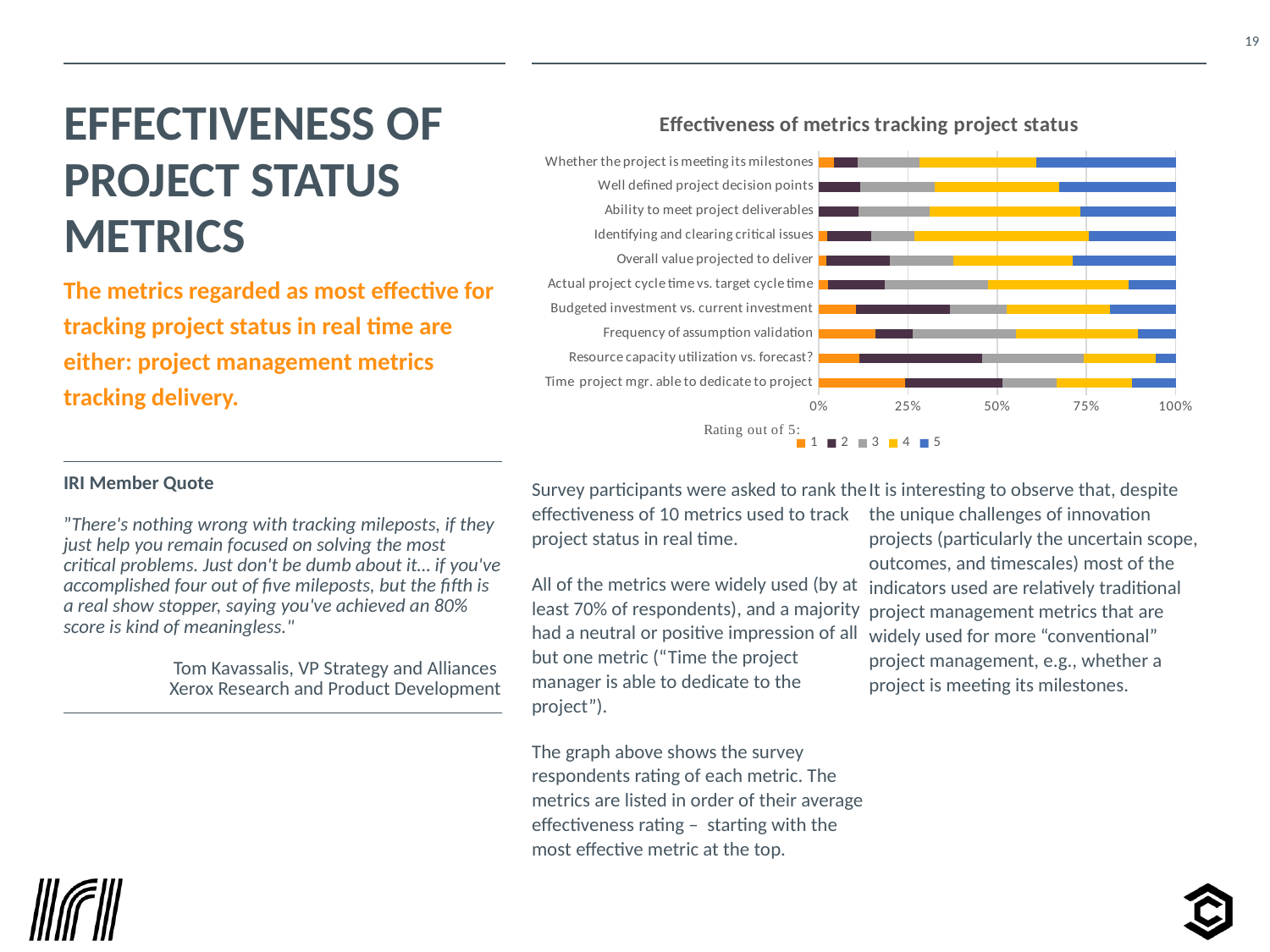
Which metric has the largest share of rating 5 responses? Whether the project is meeting its milestones Is the share of rating 5 responses for 'Time project mgr. able to dedicate to project' greater or less than 25%? less Is the share of rating 5 responses for 'Whether the project is meeting its milestones' greater or less than 25%? greater Which has a larger share of rating 1 responses: 'Time project mgr. able to dedicate to project' or 'Well defined project decision points'? Time project mgr. able to dedicate to project What is the maximum value shown on the horizontal axis of the chart? 100% How many series does the chart legend list? 5 Which metric has the largest share of rating 1 responses? Time project mgr. able to dedicate to project How many metrics (categories) are listed on the chart? 10 What kind of chart is shown on the slide? Stacked bar chart What are the legend entries of the chart? 1, 2, 3, 4, 5 What is the title of the chart? Effectiveness of metrics tracking project status Which has a larger share of rating 5 responses: 'Whether the project is meeting its milestones' or 'Resource capacity utilization vs. forecast?'? Whether the project is meeting its milestones